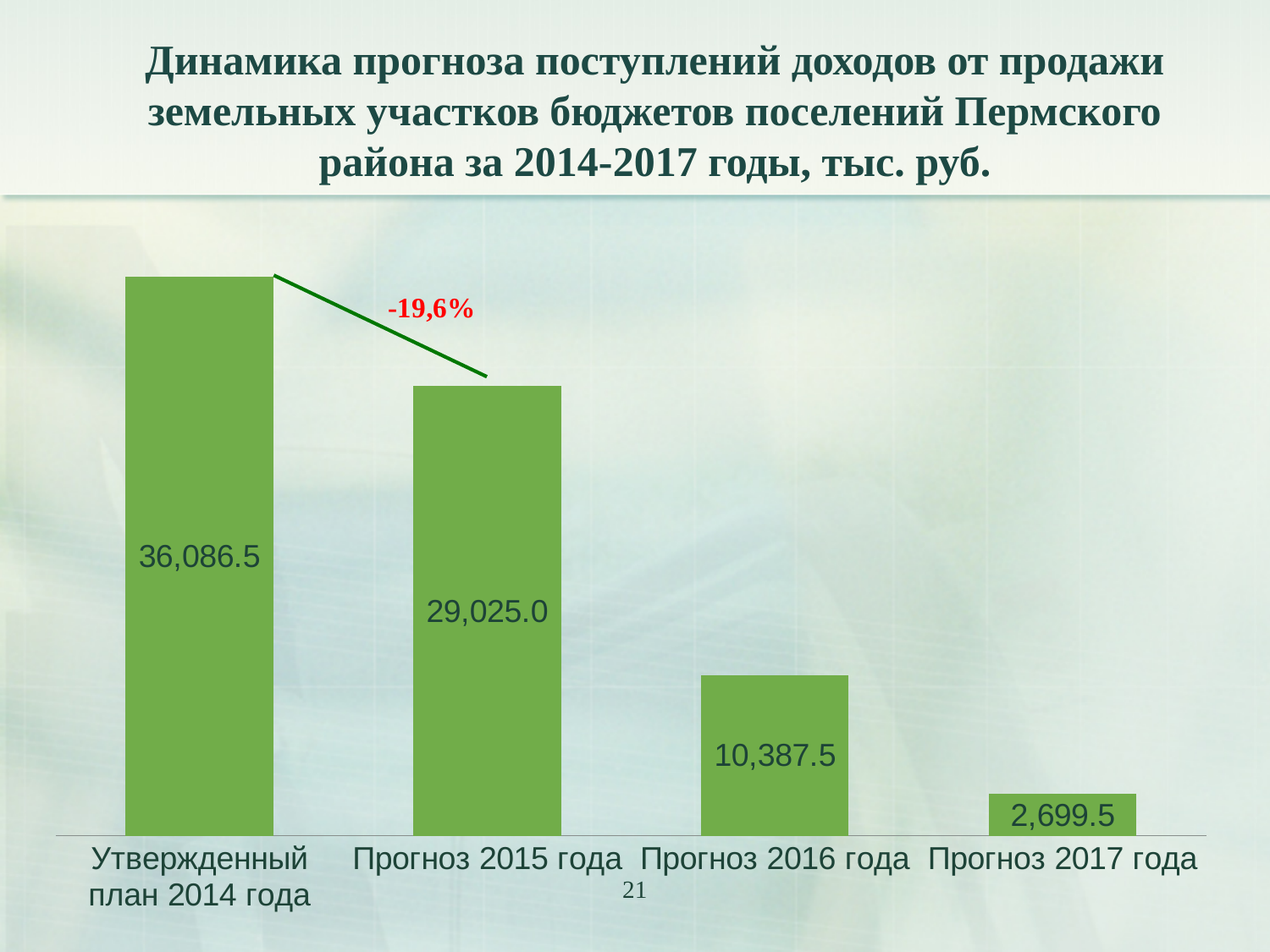
What is the value for Прогноз 2016 года? 10,387.5 Which category has the highest value? Утвержденный план 2014 года What is the difference between the values for Утвержденный план 2014 года and Прогноз 2015 года? 7,061.5 What is the value for Прогноз 2015 года? 29,025.0 Which is larger, the value for Прогноз 2015 года or the value for Прогноз 2016 года? Прогноз 2015 года What is the difference between the values for Прогноз 2016 года and Прогноз 2017 года? 7,688.0 How many categories are shown in the chart? 4 Which category has the lowest value? Прогноз 2017 года What is the value for Утвержденный план 2014 года? 36,086.5 Do the values rise or fall from left to right along the x axis? Fall What kind of chart is shown on the slide? Bar chart What is the value for Прогноз 2017 года? 2,699.5